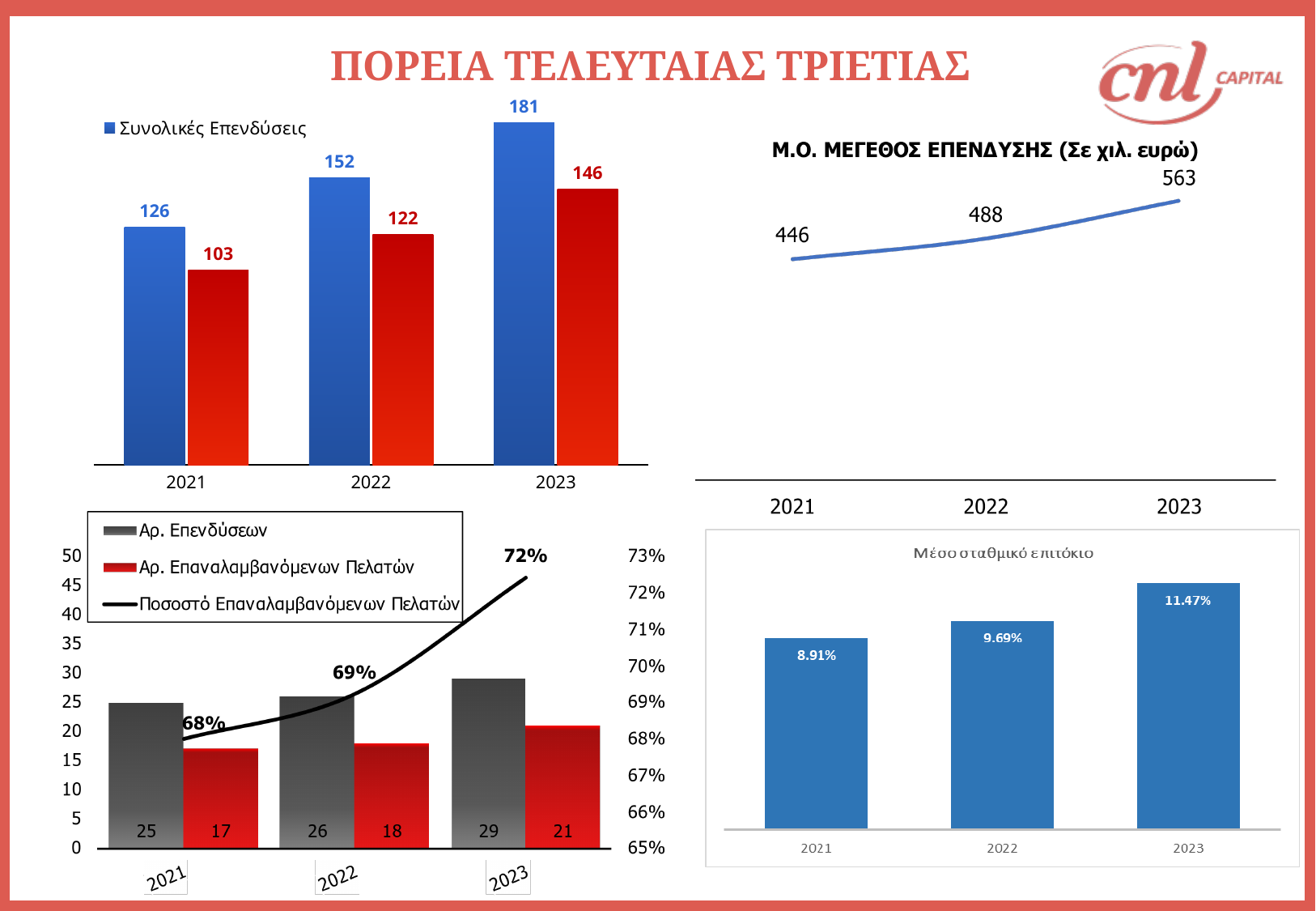
What type of chart is the one titled Μ.Ο. ΜΕΓΕΘΟΣ ΕΠΕΝΔΥΣΗΣ (Σε χιλ. ευρώ)? line chart In the top-left bar chart, which year has the highest value of Συνολικές Επενδύσεις? 2023 In the chart titled Μ.Ο. ΜΕΓΕΘΟΣ ΕΠΕΝΔΥΣΗΣ (Σε χιλ. ευρώ), what is the value for 2022? 488 In the top-left bar chart, what is the difference between Συνολικές Επενδύσεις in 2023 and 2021? 55 In the chart titled Μέσο σταθμικό επιτόκιο, what is the value for 2021? 8.91% In the bottom-left chart, what is the value of Αρ. Επαναλαμβανόμενων Πελατών for 2023? 21 In the top-left bar chart, what is the value of the red bar for 2021? 103 How many series does the legend of the bottom-left chart list? 3 In the chart titled Μ.Ο. ΜΕΓΕΘΟΣ ΕΠΕΝΔΥΣΗΣ (Σε χιλ. ευρώ), do the values rise or fall from 2021 to 2023? rise In the chart titled Μέσο σταθμικό επιτόκιο, which year has the lowest value? 2021 In the top-left bar chart, what is the value of Συνολικές Επενδύσεις for 2023? 181 In the bottom-left chart, what is the Ποσοστό Επαναλαμβανόμενων Πελατών for 2022? 69%